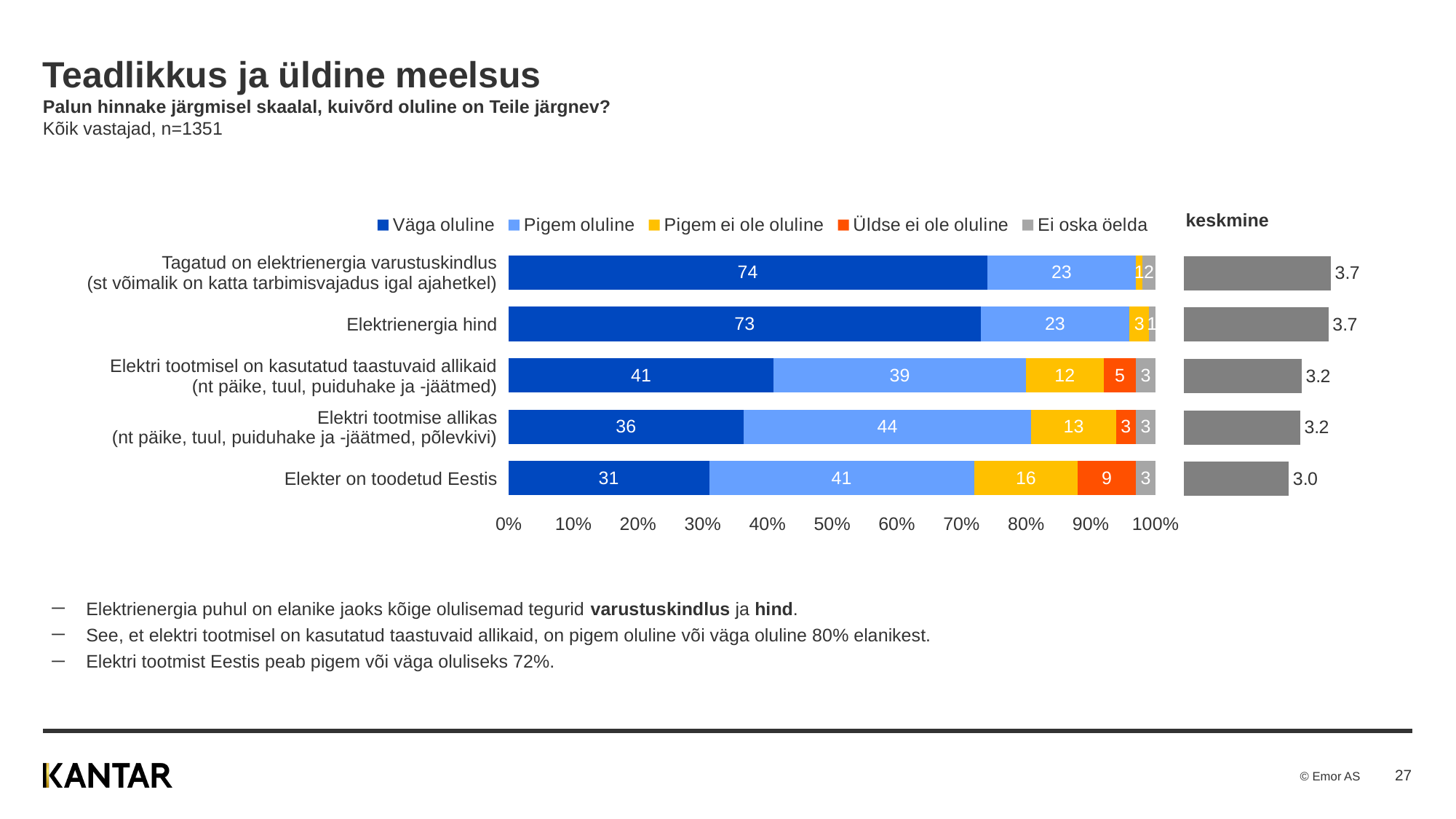
How many series does the legend of the stacked bar chart list? 5 Which has a larger 'Pigem oluline' value: 'Elektri tootmise allikas' or 'Elektri tootmisel on kasutatud taastuvaid allikaid'? Elektri tootmise allikas Which category has the highest 'Väga oluline' share? Tagatud on elektrienergia varustuskindlus What type of chart is used to show the responses? Stacked bar chart What colour represents 'Väga oluline' in the legend? Dark blue What is the 'Üldse ei ole oluline' value for 'Elekter on toodetud Eestis'? 9 How many categories (statements) are shown in the stacked bar chart? 5 What percentage of respondents rated 'Elektrienergia hind' as 'Väga oluline'? 73 Which category has the lowest 'Väga oluline' share? Elekter on toodetud Eestis What is the 'keskmine' (mean) value shown for 'Elekter on toodetud Eestis'? 3.0 What is the difference in the 'Väga oluline' value between 'Elektri tootmisel on kasutatud taastuvaid allikaid' and 'Elektri tootmise allikas'? 5 What is the 'Pigem oluline' value for 'Elekter on toodetud Eestis'? 41